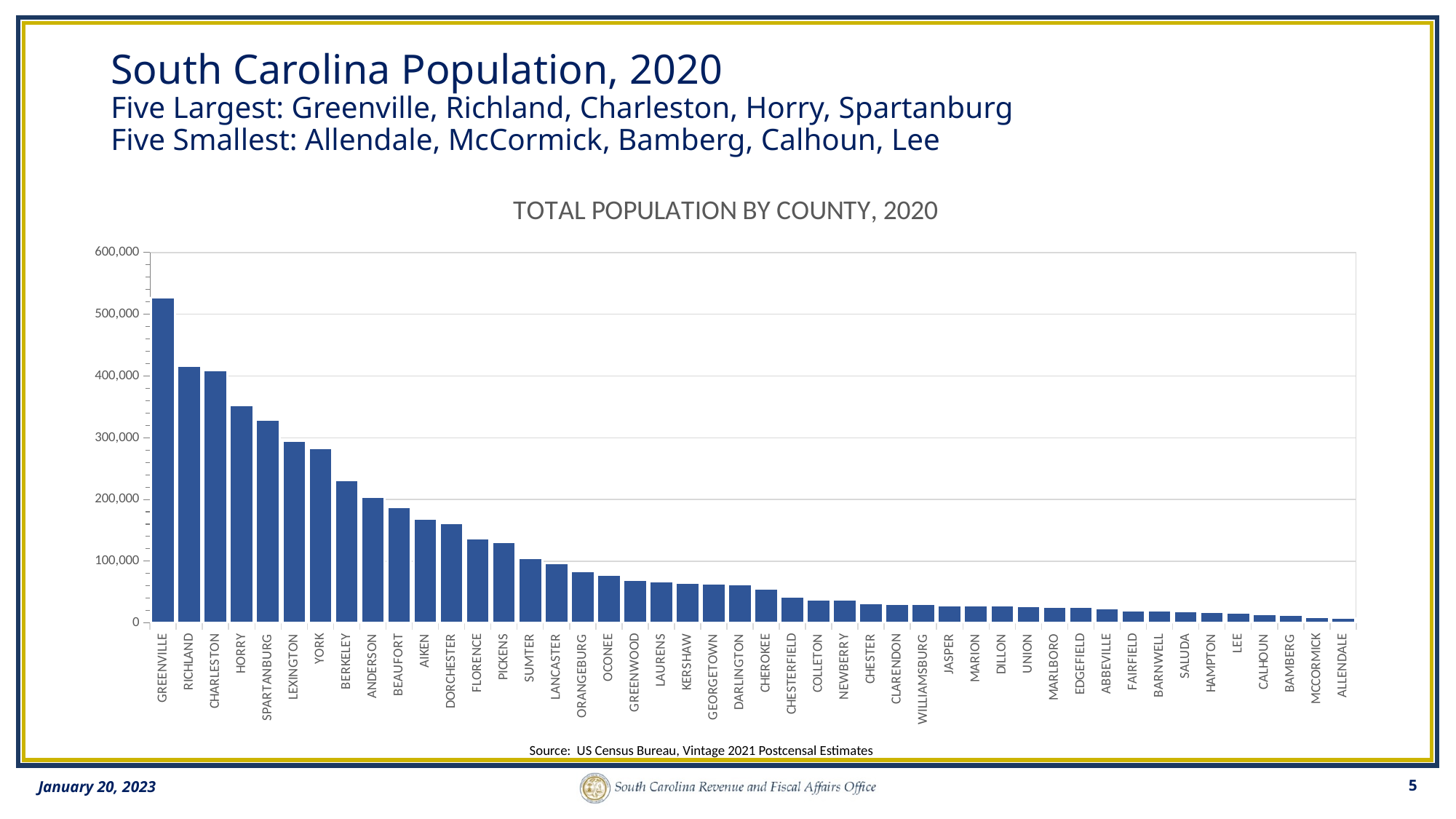
Is the value for Beaufort greater or less than 200,000? less Which county has the lowest total population in the chart? Allendale What type of chart is shown on the slide? bar chart What is the title of the chart? TOTAL POPULATION BY COUNTY, 2020 Is the value for Greenville greater or less than 500,000? greater Do the bar values rise or fall moving from left to right along the x axis? fall How many counties are plotted in the chart? 46 Which has a larger population, Horry or Spartanburg? Horry Is the value for Horry greater or less than 300,000? greater Which county has the highest total population in the chart? Greenville